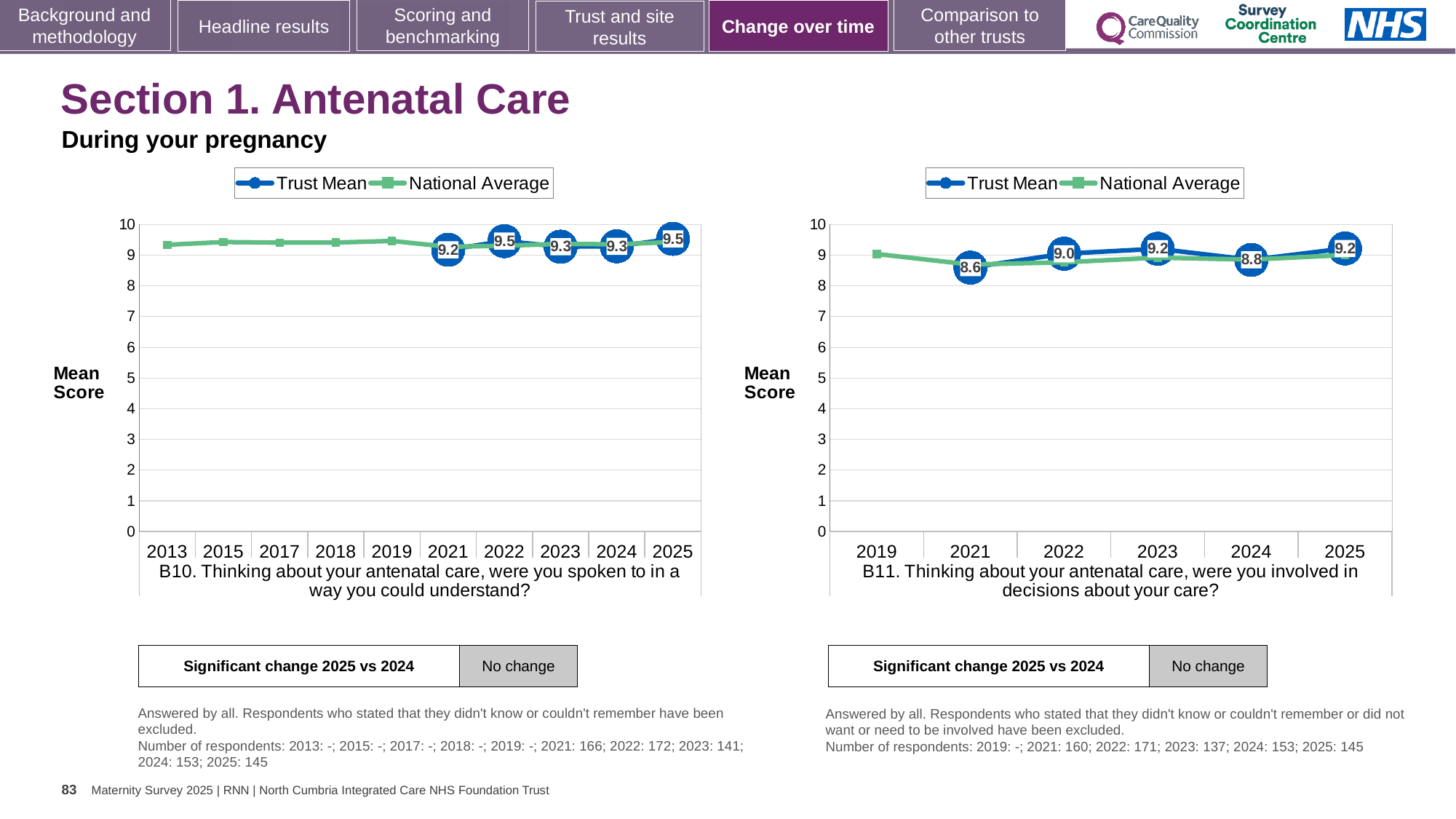
In the B11 chart, what is the Trust Mean for 2024? 8.8 In the B10 chart, which year has the lowest labelled Trust Mean? 2021 In the B10 chart, is the National Average for 2013 greater or less than 9? greater In the B11 chart, what is the difference between the Trust Mean for 2023 and the Trust Mean for 2021? 0.6 How many years are shown on the x axis of the B11 chart? 6 How many series does the legend of the B10 chart list? 2 In the B10 chart, which is larger, the Trust Mean for 2022 or the Trust Mean for 2023? 2022 In the B11 chart, which year has the lowest labelled Trust Mean? 2021 What kind of chart is the B11 chart? Line chart In the B10 chart, what is the Trust Mean for 2021? 9.2 In the B11 chart, what is the Trust Mean for 2021? 8.6 In the B10 chart, what is the Trust Mean for 2025? 9.5